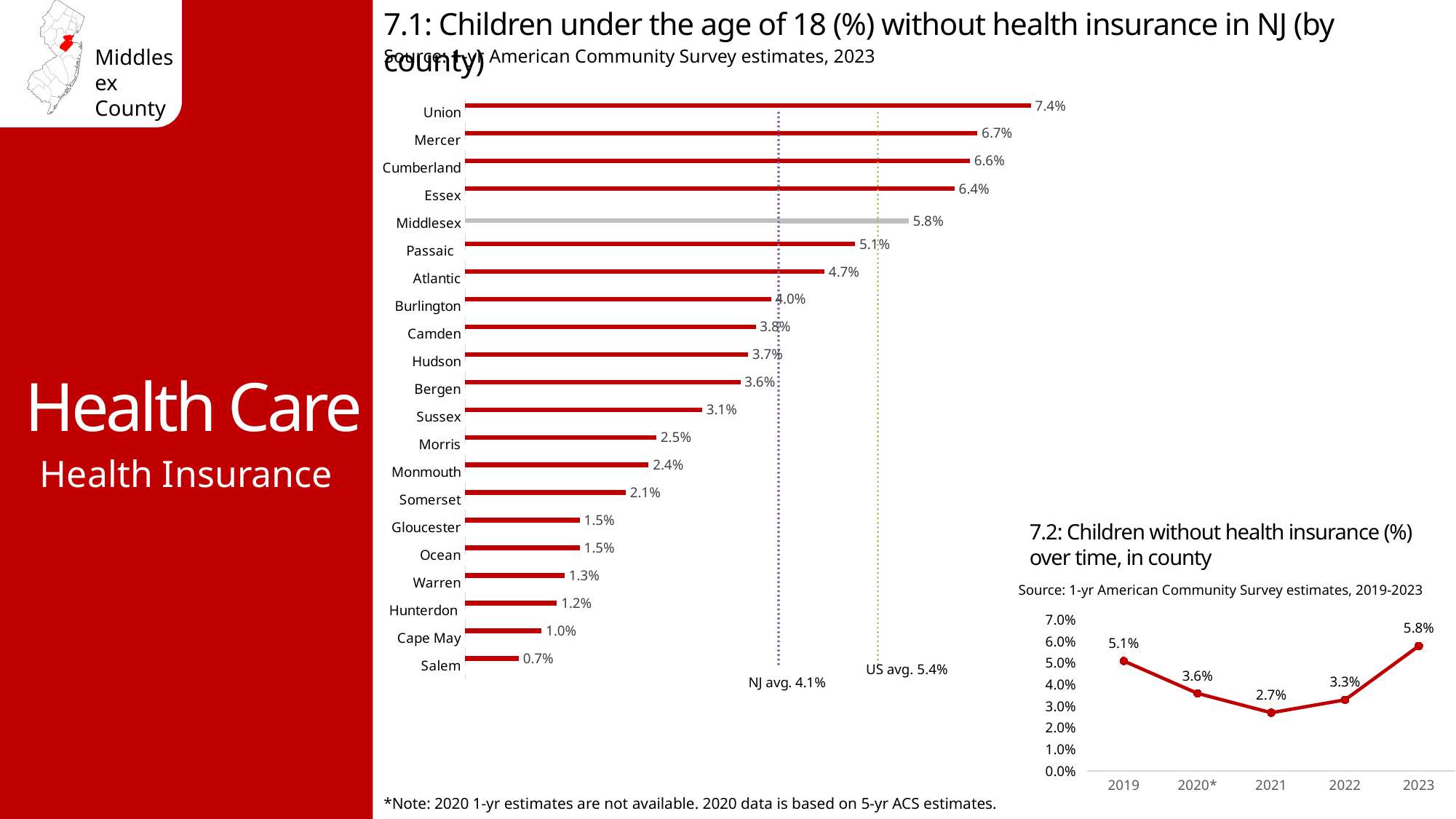
What kind of chart is chart 7.2 (children without health insurance over time)? Line chart In chart 7.1, how many counties are shown? 21 In chart 7.1, which county has the highest percentage of children without health insurance? Union In chart 7.2, how many years are plotted? 5 In chart 7.2, what is the difference between the 2023 value and the 2022 value? 2.5% In chart 7.2, what is the value for 2021? 2.7% In chart 7.1, which county has a higher value, Essex or Passaic? Essex In chart 7.1, what is the difference between the values for Union and Salem? 6.7% In chart 7.1, what is the NJ average shown by the dotted reference line? 4.1% In chart 7.1, what is the value for Hudson? 3.7% In chart 7.1 (children under 18 without health insurance by county), what is the value for Middlesex? 5.8% In chart 7.1, which county has the lowest percentage of children without health insurance? Salem